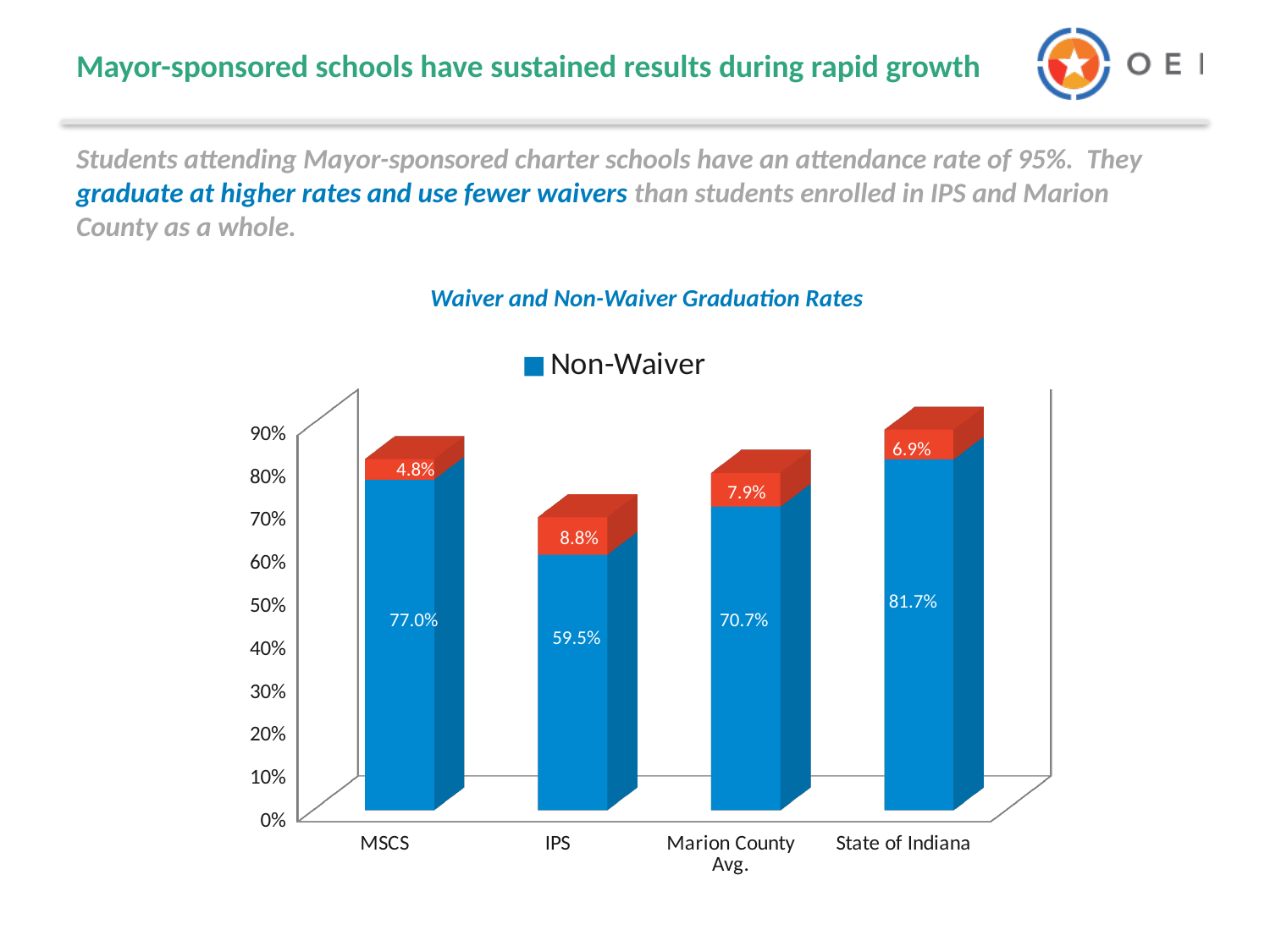
What is the total height of the stacked bar for MSCS? 81.8% What is the Non-Waiver graduation rate for MSCS? 77.0% What is the total height of the stacked bar for State of Indiana? 88.6% What is the value of the red (top) segment for State of Indiana? 6.9% What is the difference between the Non-Waiver graduation rates of MSCS and IPS? 17.5% What is the title of the chart? Waiver and Non-Waiver Graduation Rates Which category has the lowest Non-Waiver graduation rate? IPS Which category has the highest Non-Waiver graduation rate? State of Indiana What is the Non-Waiver graduation rate for IPS? 59.5% How many categories are shown on the x axis? 4 Which has a larger red (top) segment, IPS or MSCS? IPS What is the value of the red (top) segment for Marion County Avg.? 7.9%